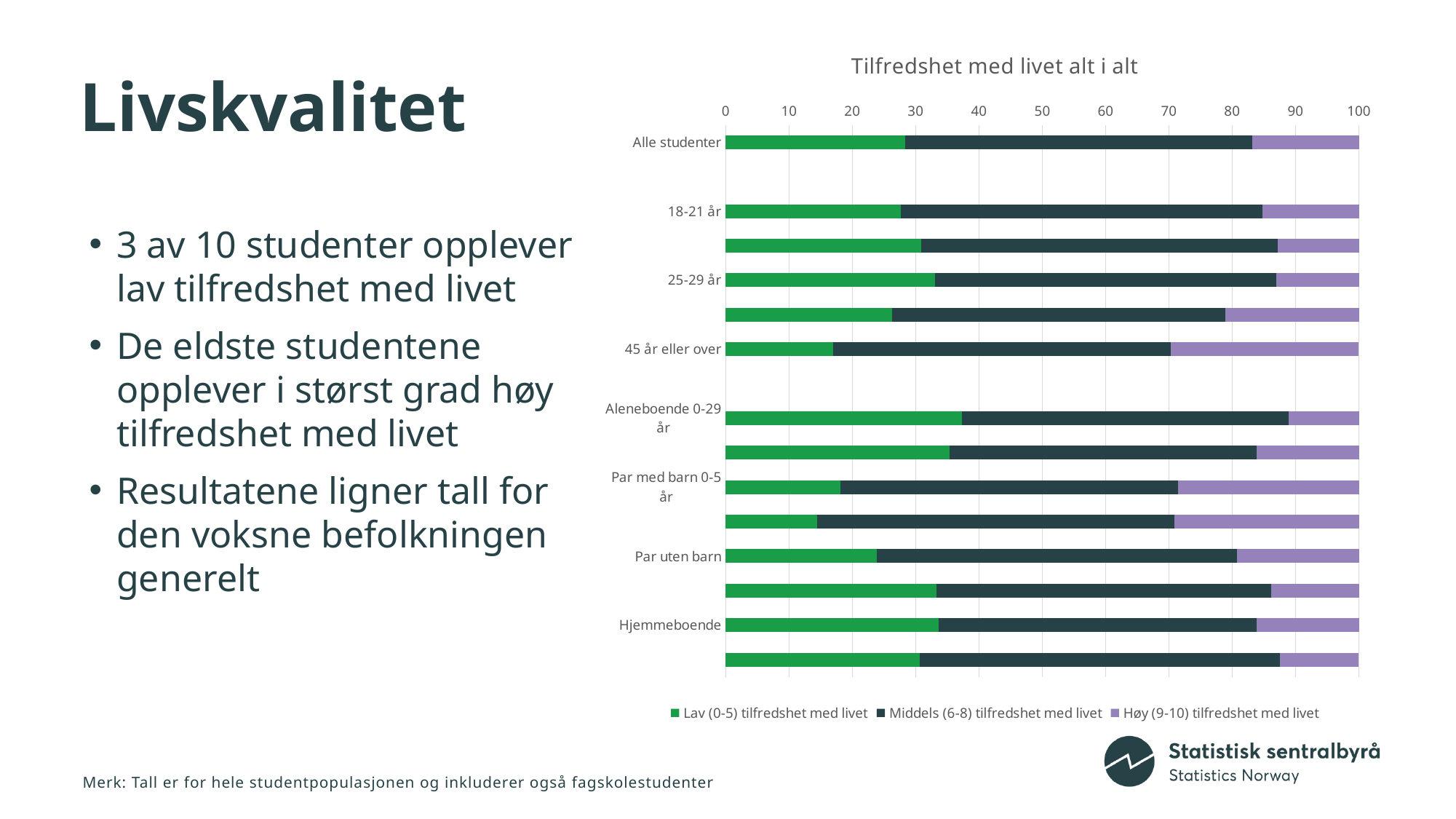
What is the total of the stacked bar for Alle studenter? 100 What is the title of the chart? Tilfredshet med livet alt i alt Is the value of Lav (0-5) tilfredshet med livet for Alle studenter greater or less than 30? less Is the value of Høy (9-10) tilfredshet med livet for 45 år eller over greater or less than 20? greater Is the value of Lav (0-5) tilfredshet med livet for 45 år eller over greater or less than 20? less Among the labelled categories, which has the largest Høy (9-10) tilfredshet med livet segment? 45 år eller over Which has a larger Lav (0-5) tilfredshet med livet value: Aleneboende 0-29 år or 45 år eller over? Aleneboende 0-29 år What kind of chart is shown on the slide? stacked bar chart How many series does the chart legend list? 3 Which series is shown in purple in the chart? Høy (9-10) tilfredshet med livet